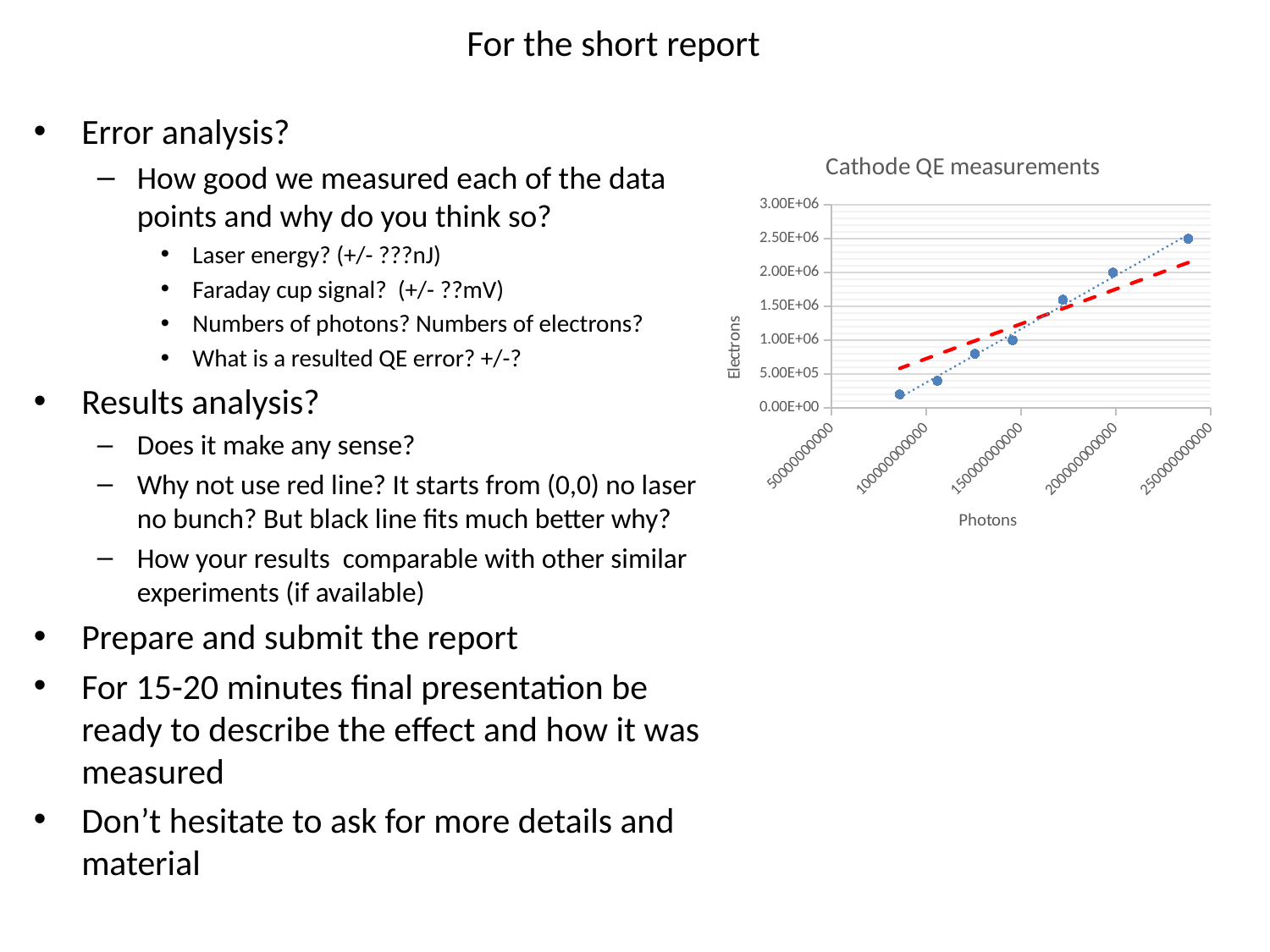
Is the value of the rightmost data point greater or less than 2.00E+06 electrons? greater What is the highest tick value shown on the y axis of the chart? 3.00E+06 Which data point has the larger electron value, the leftmost one or the rightmost one? the rightmost one Is the value of the leftmost data point greater or less than 5.00E+05 electrons? less What kind of chart is shown on the slide? scatter chart Is the value of the data point just left of the 15000000000 photons tick greater or less than 1.50E+06 electrons? less Do the plotted values rise or fall as the number of photons increases along the x axis? rise What are the labels of the x axis and the y axis of the chart? Photons (x axis) and Electrons (y axis) What is the title of the chart? Cathode QE measurements How many data points are plotted in the chart? 7